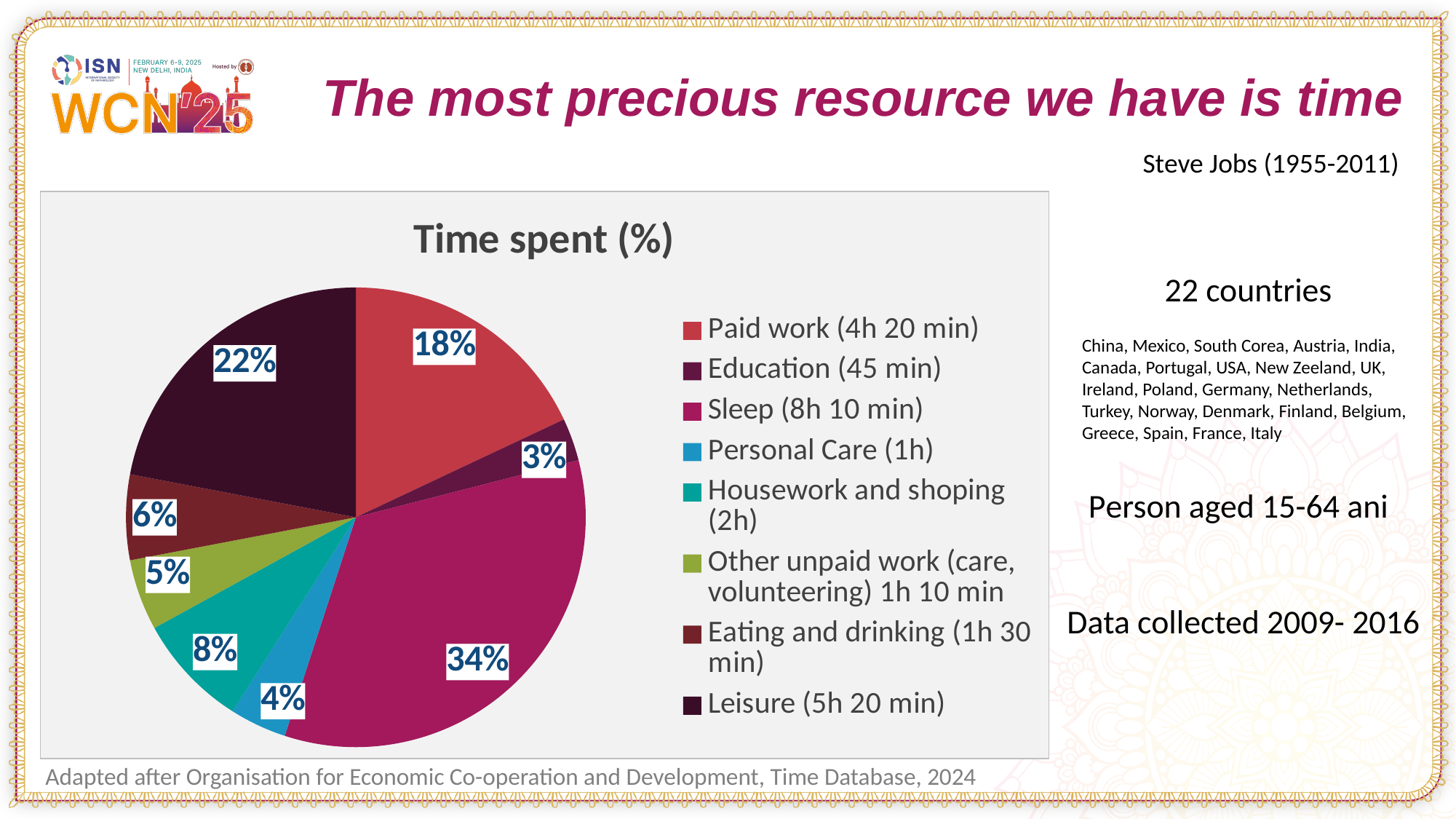
How many slices does the pie chart have? 8 What type of chart is shown on the slide? pie chart According to the legend, how much time is spent on Leisure? 5h 20 min Which category has the smallest share of the pie? Education What percentage of time is spent on Leisure? 22% Which category has the largest share of the pie? Sleep What percentage of time is spent on Sleep? 34% Which is larger, the share for Eating and drinking or the share for Personal Care? Eating and drinking What is the difference in percentage points between Sleep and Leisure? 12 What is the title of the chart? Time spent (%) What percentage of time is spent on Paid work? 18% What percentage of time is spent on Housework and shoping? 8%